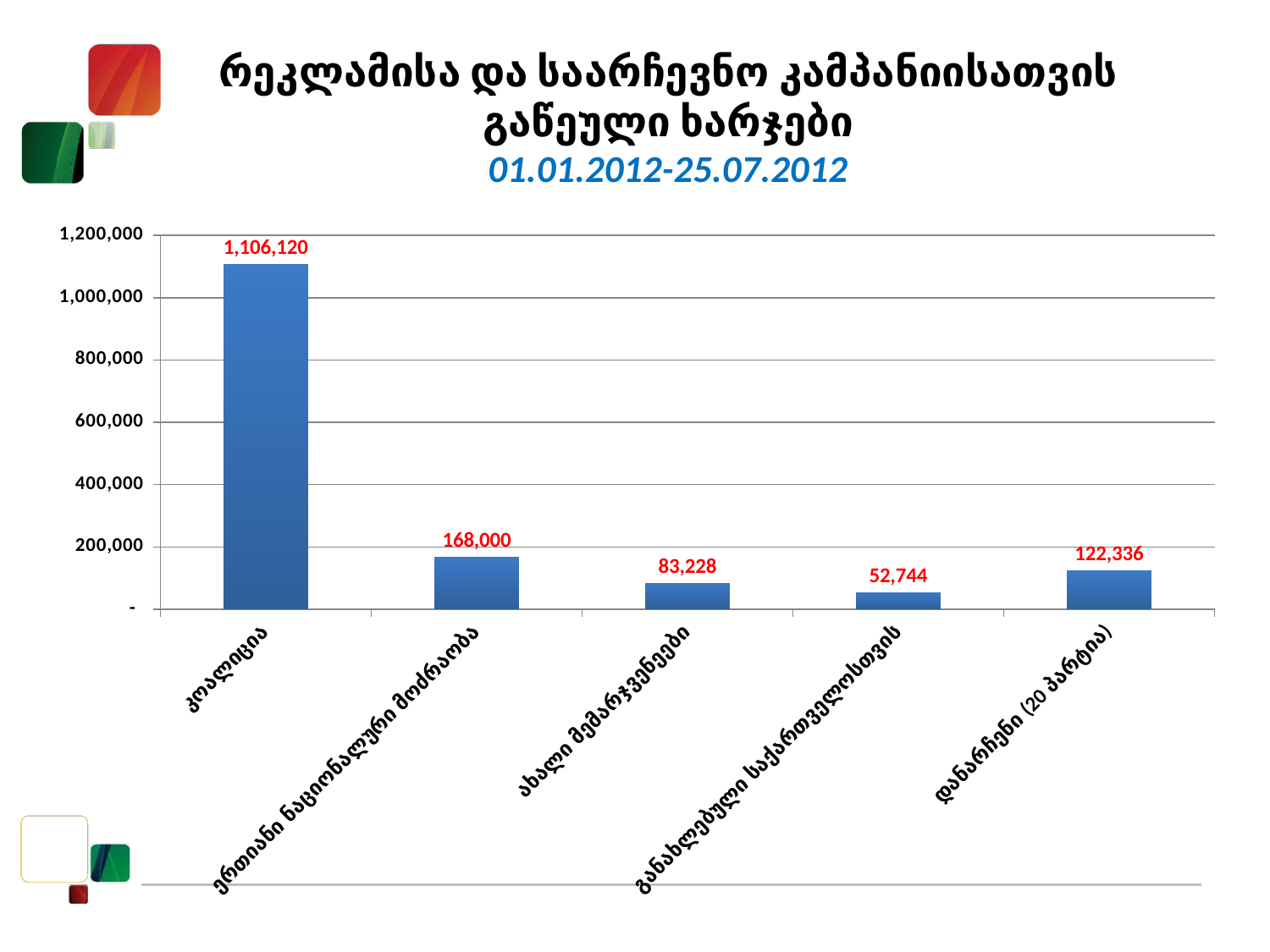
Which category has the lowest value? განახლებული საქართველოსთვის What is the value for ახალი მემარჯვენეები? 83,228 What is the value for დანარჩენი (20 პარტია)? 122,336 Which is larger, the value for ახალი მემარჯვენეები or the value for დანარჩენი (20 პარტია)? დანარჩენი (20 პარტია) What kind of chart is shown on the slide? Bar chart How many categories are shown on the chart? 5 What is the value for კოალიცია? 1,106,120 What date range is shown in the chart's subtitle? 01.01.2012-25.07.2012 What is the difference between the values for ერთიანი ნაციონალური მოძრაობა and დანარჩენი (20 პარტია)? 45,664 Which category has the highest value? კოალიცია What is the value for განახლებული საქართველოსთვის? 52,744 What is the value for ერთიანი ნაციონალური მოძრაობა? 168,000